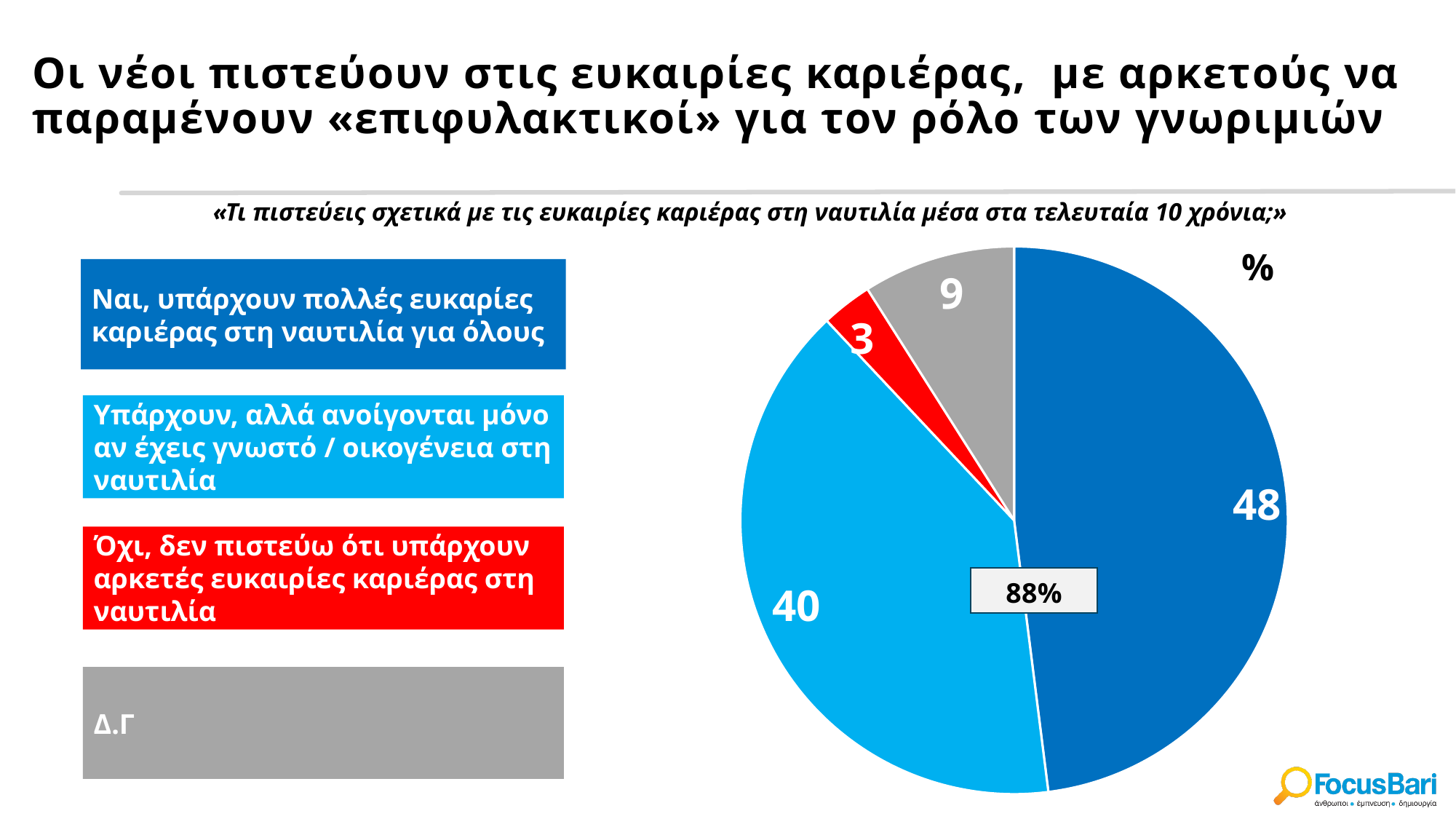
Which category has the largest slice of the pie? Ναι, υπάρχουν πολλές ευκαιρίες καριέρας στη ναυτιλία για όλους What colour is the slice for "Όχι, δεν πιστεύω ότι υπάρχουν αρκετές ευκαιρίες καριέρας στη ναυτιλία"? red What is the value for the slice "Δ.Γ"? 9 What is the value for the slice "Υπάρχουν, αλλά ανοίγονται μόνο αν έχεις γνωστό / οικογένεια στη ναυτιλία"? 40 How many slices does the pie chart have? 4 Which category has the smallest slice of the pie? Όχι, δεν πιστεύω ότι υπάρχουν αρκετές ευκαιρίες καριέρας στη ναυτιλία What kind of chart is shown on the slide? pie chart What is the difference between the value for "Ναι, υπάρχουν πολλές ευκαιρίες καριέρας στη ναυτιλία για όλους" and the value for "Υπάρχουν, αλλά ανοίγονται μόνο αν έχεις γνωστό / οικογένεια στη ναυτιλία"? 8 What percentage is shown in the callout box on the pie chart? 88% What is the value for the slice "Όχι, δεν πιστεύω ότι υπάρχουν αρκετές ευκαιρίες καριέρας στη ναυτιλία"? 3 What is the value for the slice "Ναι, υπάρχουν πολλές ευκαιρίες καριέρας στη ναυτιλία για όλους"? 48 Which is larger: the value for "Δ.Γ" or the value for "Όχι, δεν πιστεύω ότι υπάρχουν αρκετές ευκαιρίες καριέρας στη ναυτιλία"? Δ.Γ